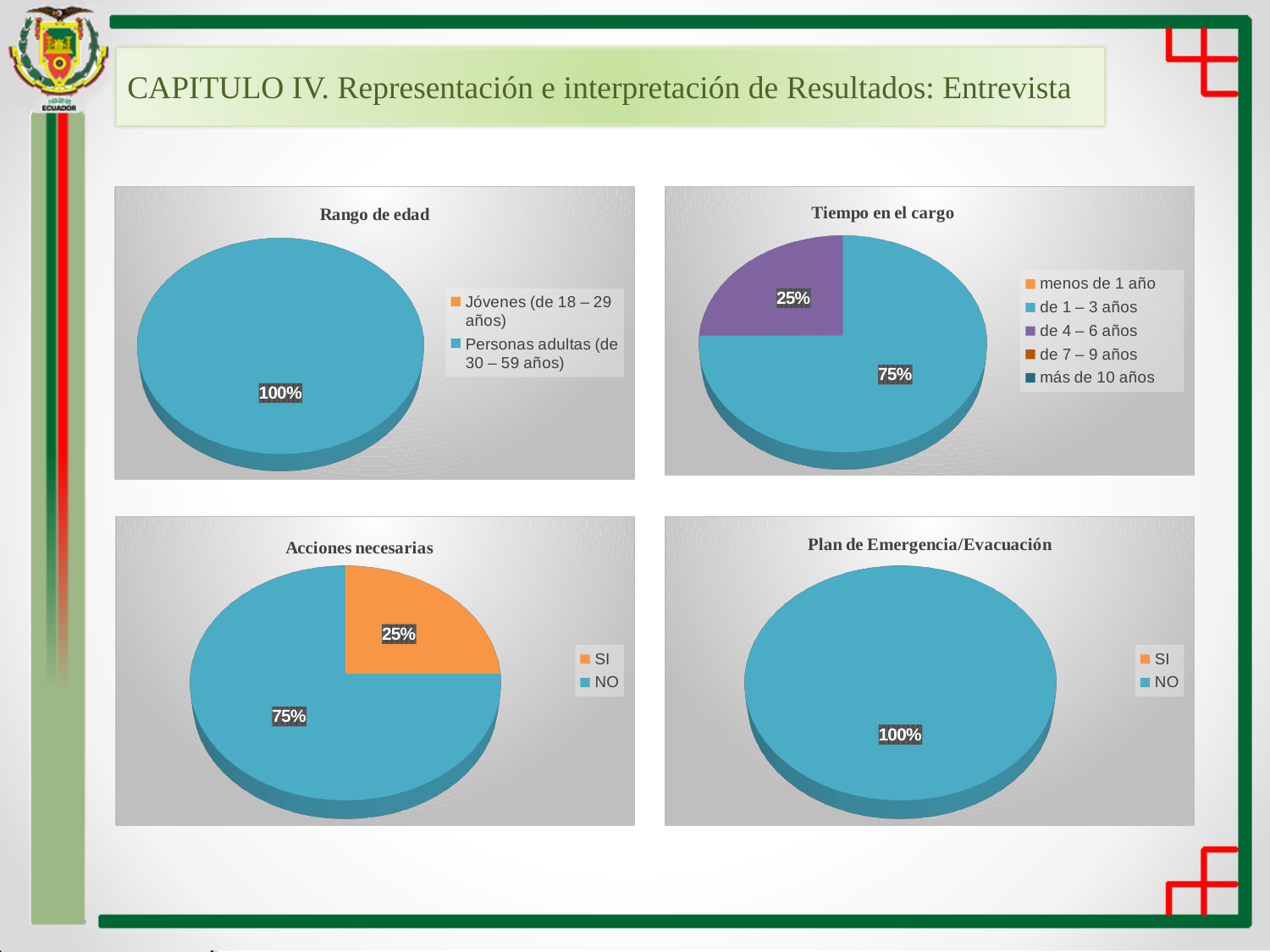
In the "Rango de edad" chart, what share of the pie is "Personas adultas (de 30 – 59 años)"? 100% In the "Tiempo en el cargo" chart, how many categories does the legend list? 5 In the "Tiempo en el cargo" chart, what share of the pie is "de 4 – 6 años"? 25% How many charts are shown on the slide? 4 What kind of chart is the "Plan de Emergencia/Evacuación" chart? Pie chart In the "Plan de Emergencia/Evacuación" chart, what share of the pie is "NO"? 100% In the "Acciones necesarias" chart, which is larger, "SI" or "NO"? NO In the "Tiempo en el cargo" chart, which category has the largest slice? de 1 – 3 años In the "Acciones necesarias" chart, what is the difference between the "NO" and "SI" shares? 50%